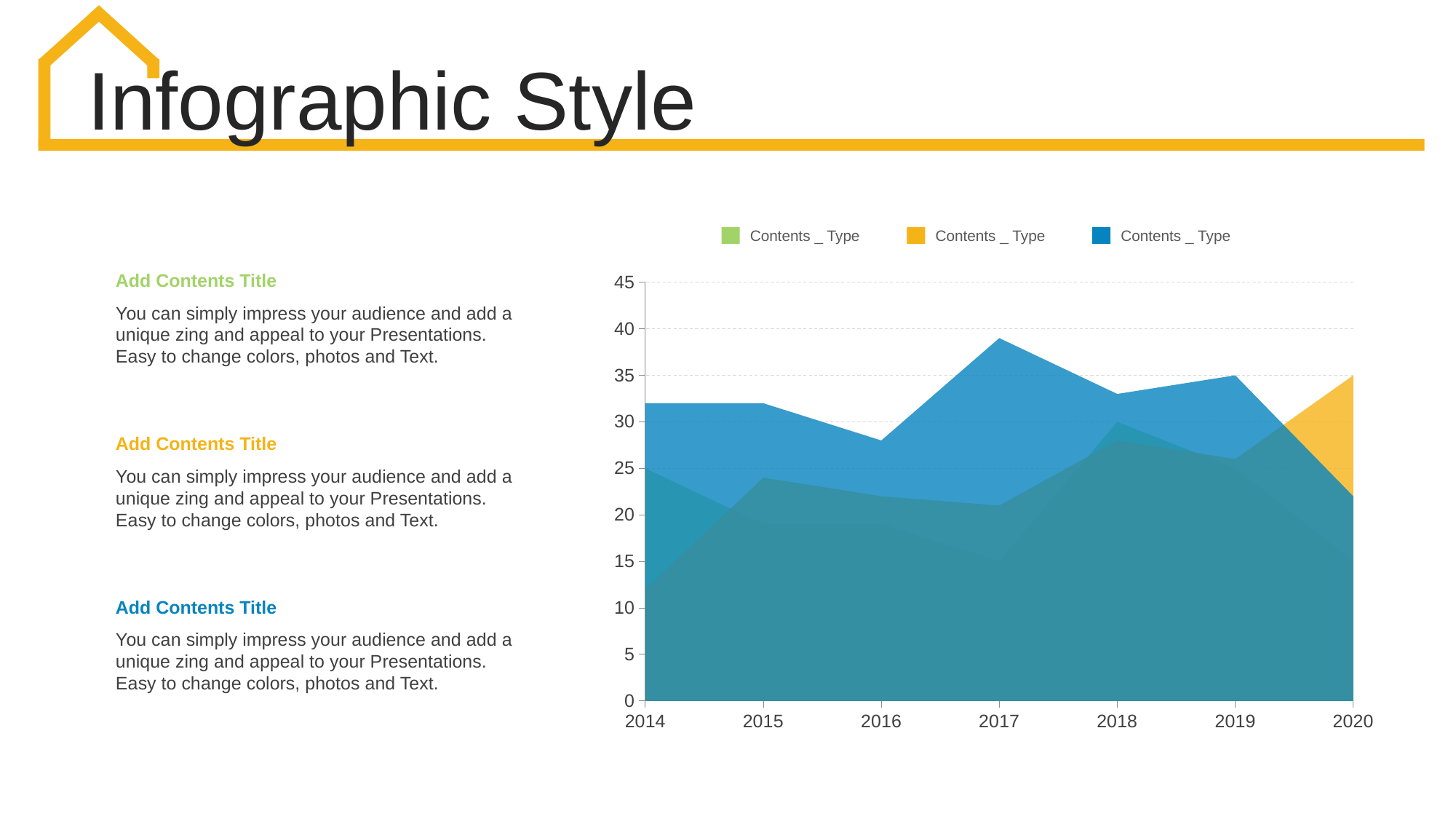
What kind of chart is shown on the slide? Area chart In which year does the blue series reach its highest value? 2017 In which year does the blue series reach its lowest value? 2020 What is the highest value shown on the chart's y axis? 45 Which is larger for the orange series: the value in 2018 or the value in 2017? 2018 Is the value of the blue series in 2017 greater or less than 35? greater How many years are shown along the x axis of the chart? 7 Does the blue series rise or fall from 2019 to 2020? fall How many series does the chart legend list? 3 In which year does the orange series reach its highest value? 2020 Is the value of the orange series in 2020 greater or less than 30? greater Is the value of the blue series in 2020 greater or less than 25? less